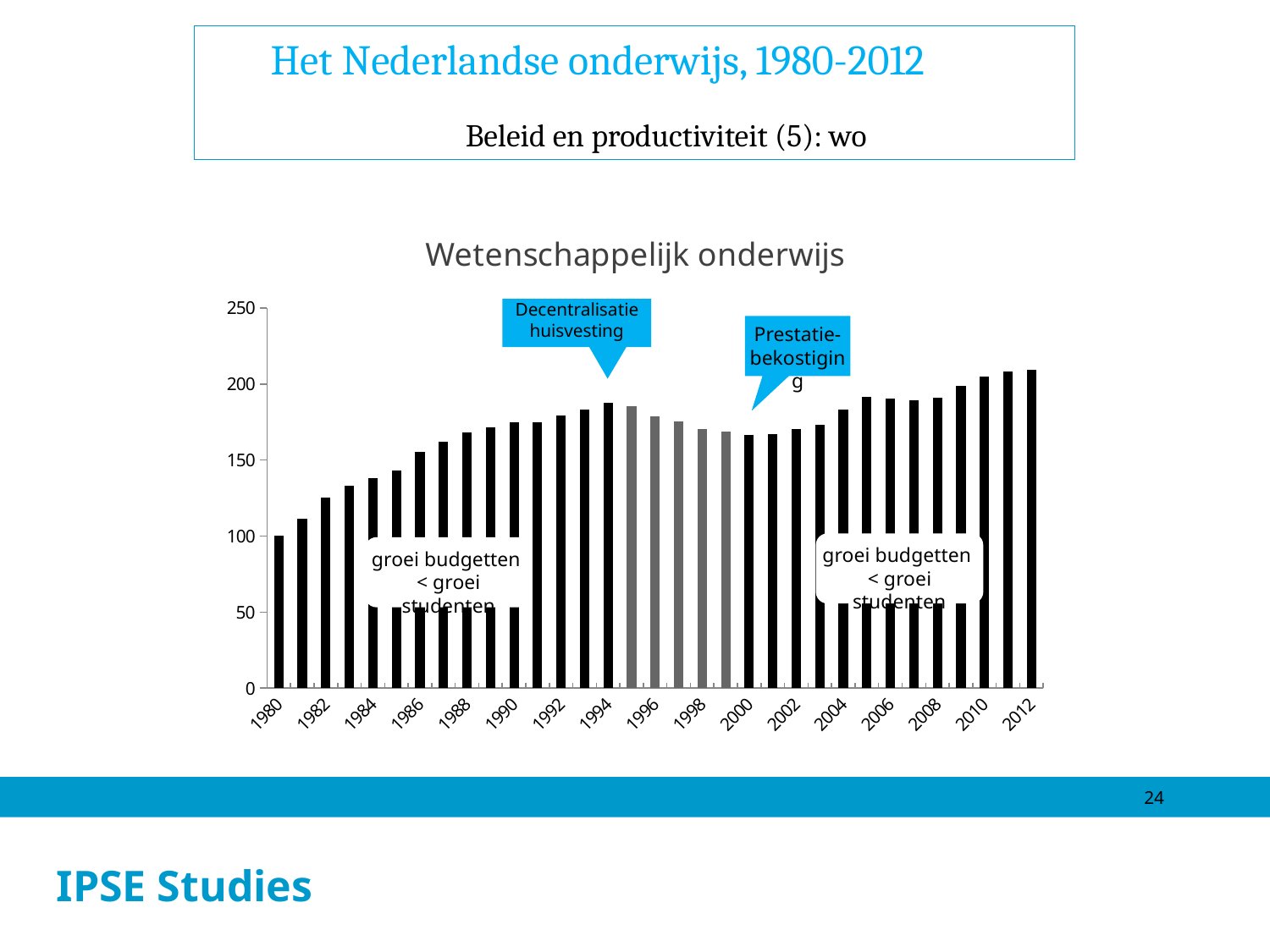
Which policy annotation is placed above the bars around 1994? Decentralisatie huisvesting What is the title of the chart? Wetenschappelijk onderwijs Is the value for 2000 greater or less than 200? less How many years (bars) are plotted in the chart? 33 Which year has the lowest value? 1980 What is the value for 1980? 100 What kind of chart is shown on the slide? bar chart Which is larger, the value for 1994 or the value for 2000? 1994 Is the value for 1990 greater or less than 150? greater Is the value for 1984 greater or less than 150? less Do the values rise or fall from 1980 to 1994? rise